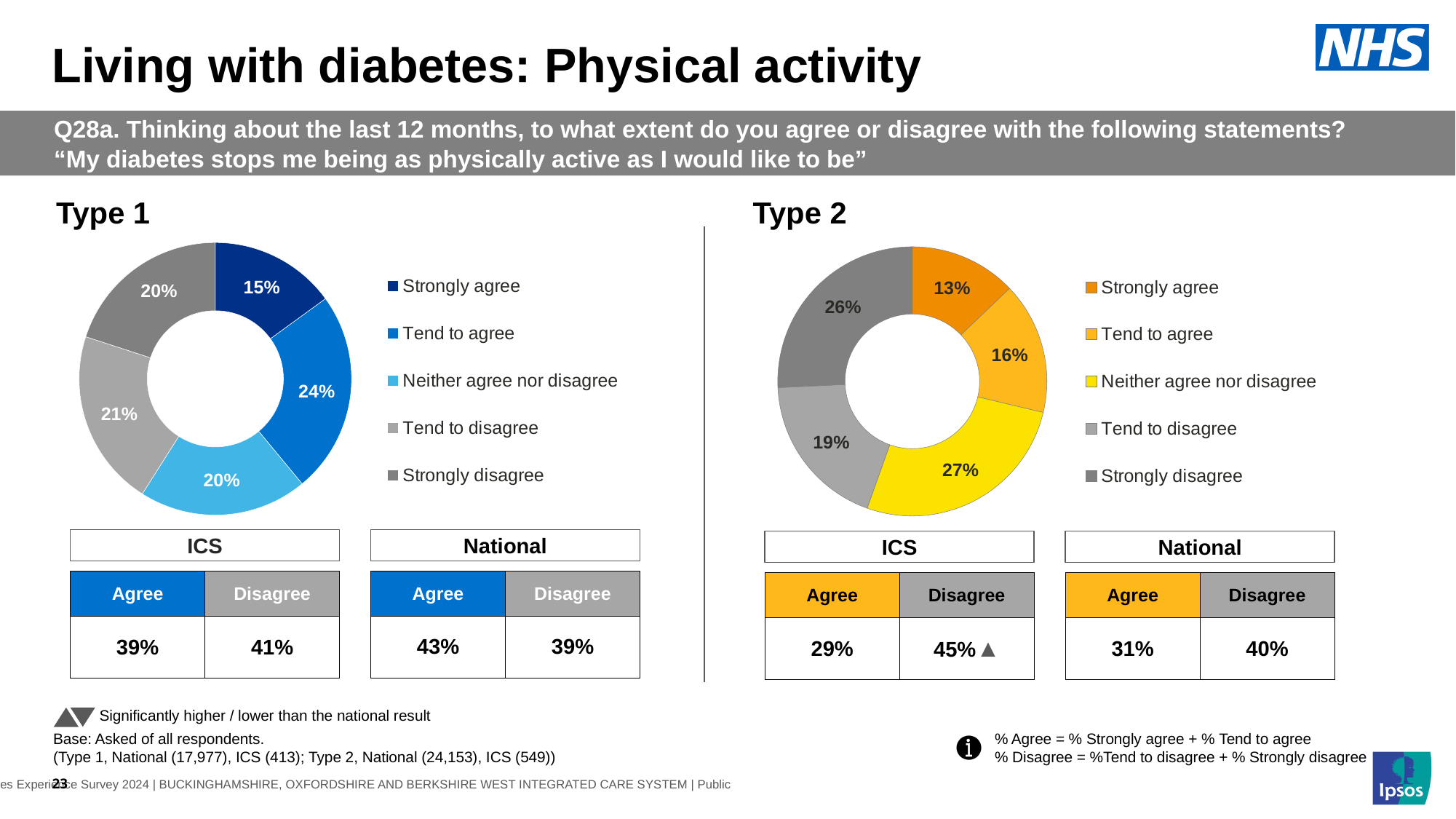
In the Type 2 chart, which response category has the largest share? Neither agree nor disagree In the Type 2 chart, what percentage of respondents said they strongly disagree? 26% In the Type 1 chart, what percentage of respondents said they tend to disagree? 21% In the Type 2 chart, what colour is the 'Neither agree nor disagree' segment? Yellow In the Type 1 chart, what is the difference in percentage points between 'Tend to agree' and 'Strongly agree'? 9 In the Type 1 chart, which response category has the largest share? Tend to agree In the Type 2 chart, which response category has the smallest share? Strongly agree In the Type 2 chart, what percentage of respondents said they neither agree nor disagree? 27% In the Type 1 chart, what percentage of respondents said they strongly agree? 15% How many response categories does the legend of the Type 1 chart list? 5 In the Type 2 chart, which is larger: the share for 'Strongly disagree' or the share for 'Tend to disagree'? Strongly disagree What kind of chart is used for the Type 2 results? Donut chart